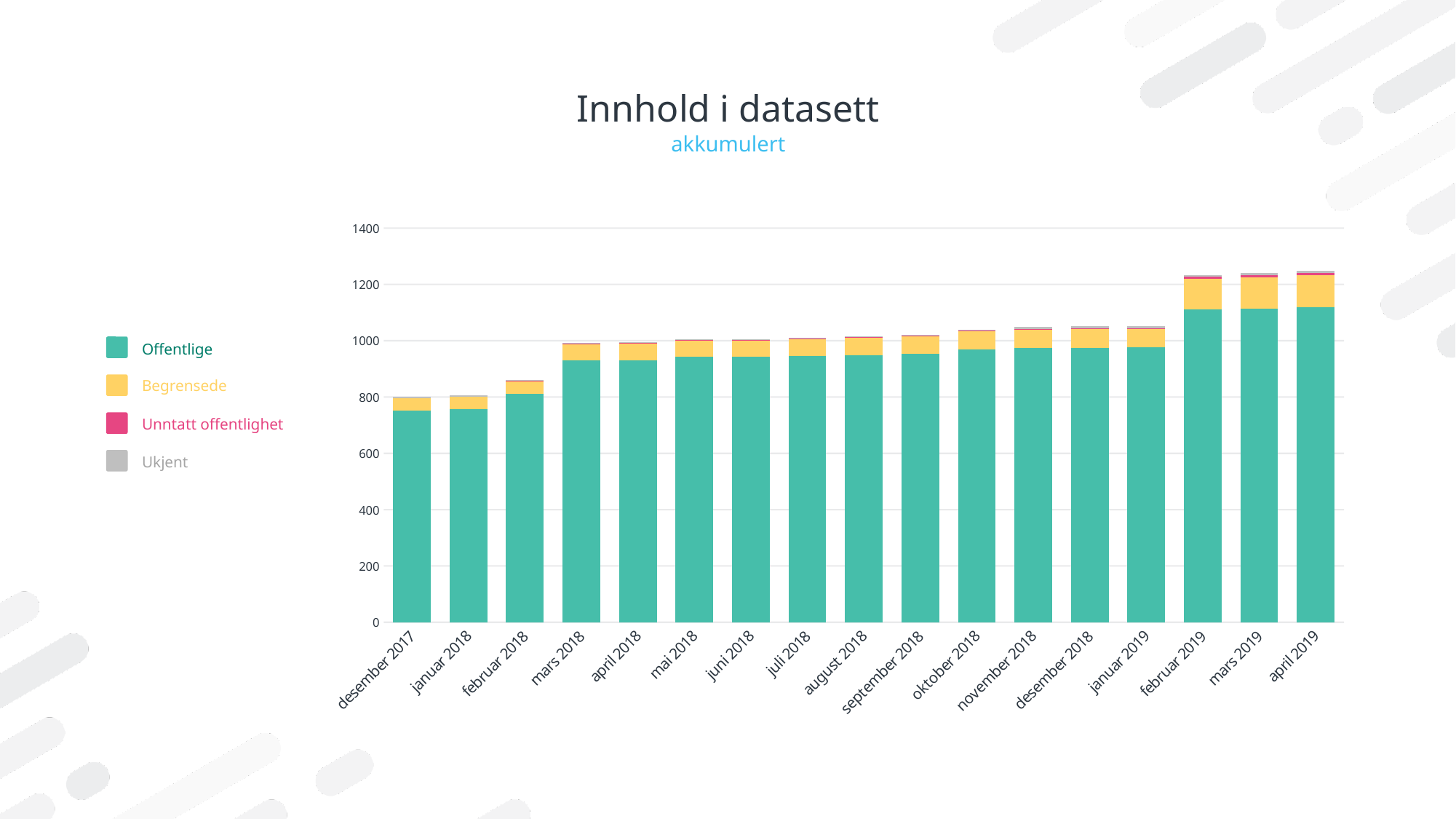
What kind of chart is shown on the slide? stacked bar chart How many months (bars) are shown on the x axis? 17 Which has the larger total, januar 2019 or februar 2019? februar 2019 Is the total for februar 2019 greater or less than 1200? greater Do the total bar heights rise or fall from desember 2017 to april 2019? rise How many series does the legend list? 4 Is the Offentlige value for mars 2018 greater or less than 1000? less Which series is shown in green? Offentlige Which has the larger Offentlige value, desember 2017 or februar 2018? februar 2018 What is the subtitle of the chart? akkumulert Is the total for februar 2018 greater or less than 800? greater